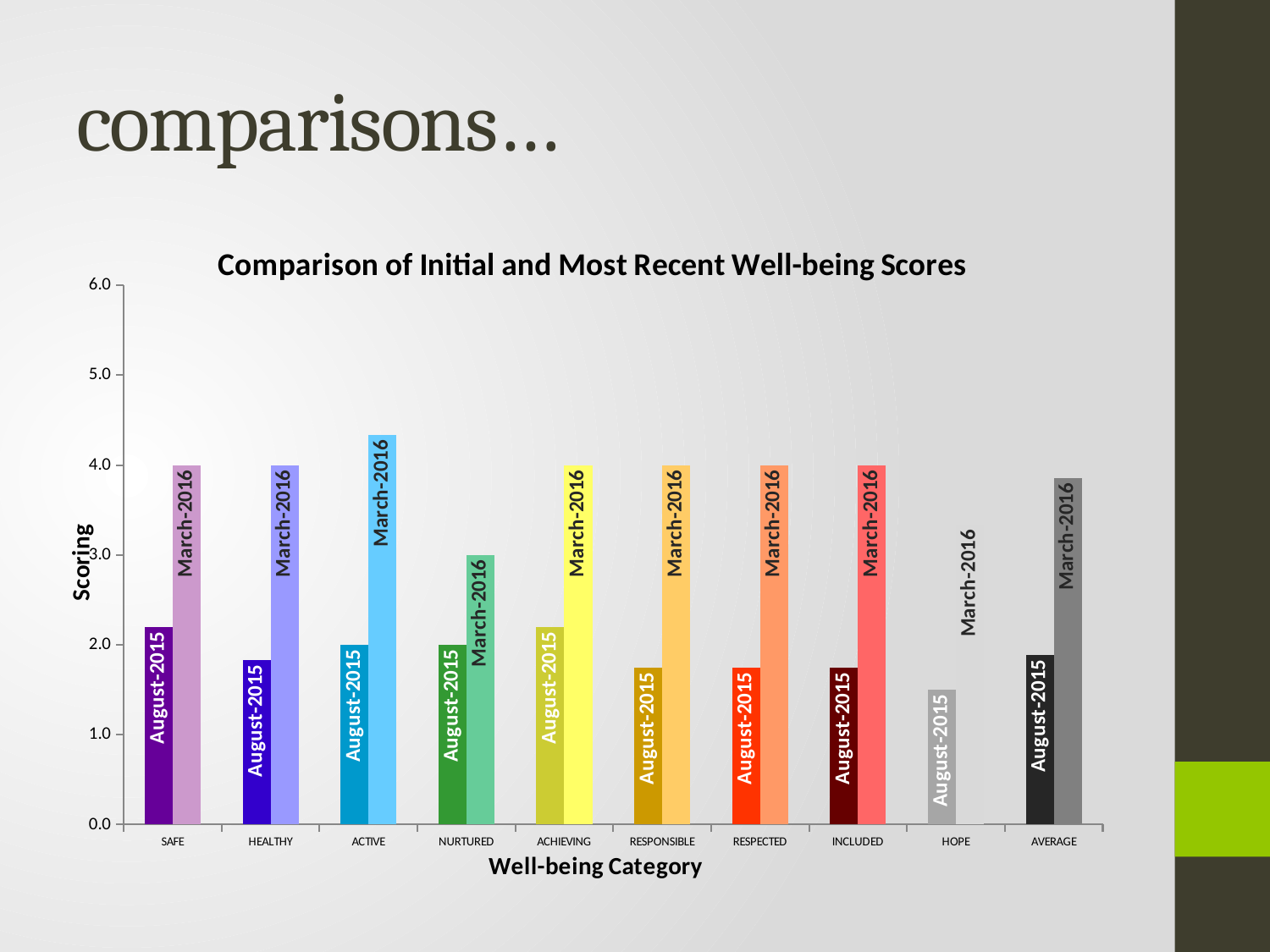
Which category has the highest March-2016 score? ACTIVE For SAFE, which is larger: the August-2015 score or the March-2016 score? March-2016 Is the March-2016 value for ACTIVE greater or less than 4.0? greater Which category has the lowest August-2015 score? HOPE How many well-being categories are shown on the x axis? 10 What is the title of the chart? Comparison of Initial and Most Recent Well-being Scores How many data series are plotted for each category? 2 What is the March-2016 score for NURTURED? 3.0 What is the difference between the March-2016 and August-2015 scores for NURTURED? 1.0 What type of chart is shown on the slide? bar chart What is the March-2016 score for SAFE? 4.0 Is the August-2015 value for HOPE greater or less than 2.0? less